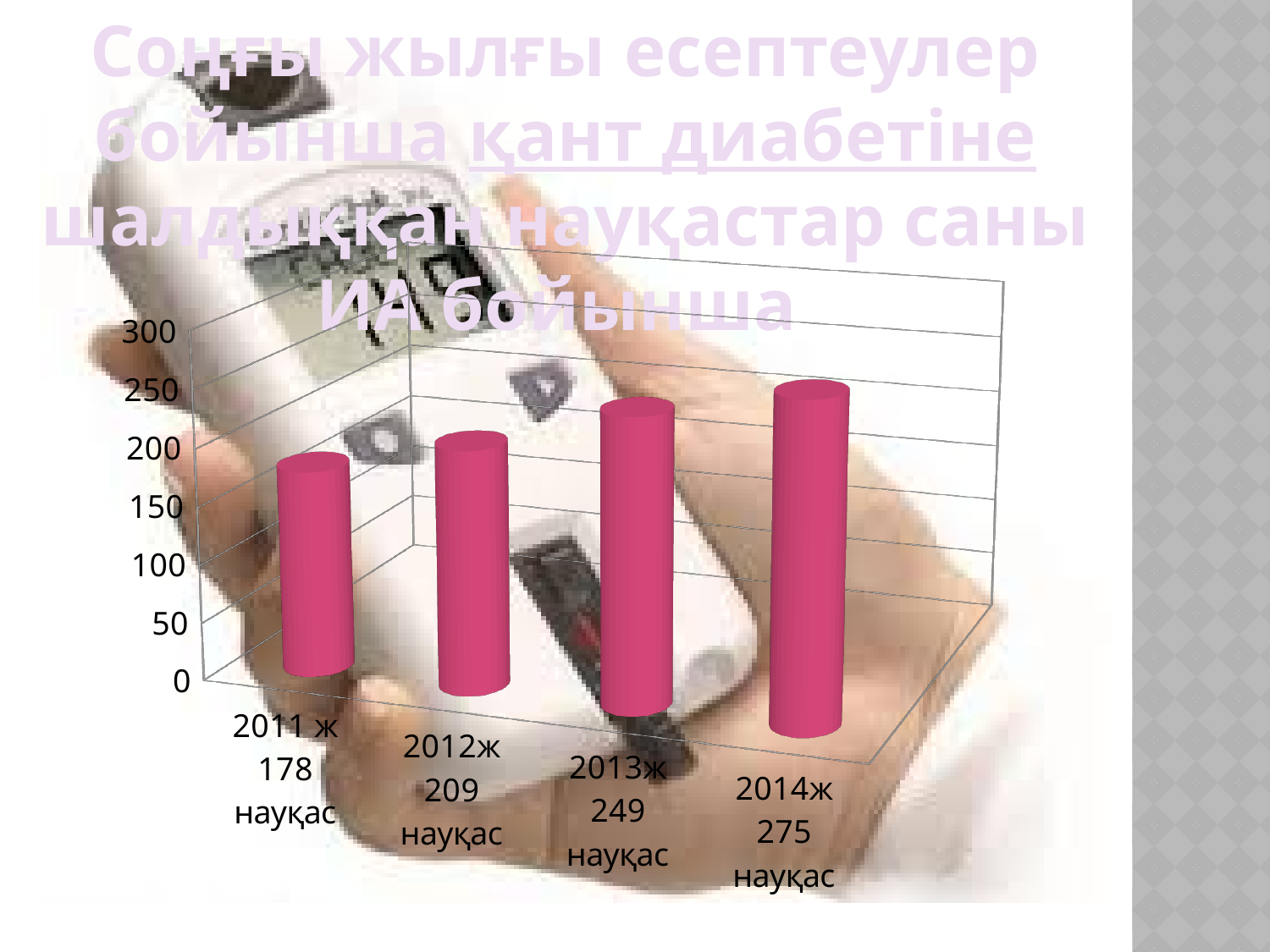
Do the values rise or fall from 2011 ж to 2014ж along the x axis? rise How many patients (науқас) are shown for 2012ж? 209 How many patients (науқас) are shown for 2013ж? 249 What kind of chart is shown on the slide? bar chart Which year has the highest number of patients? 2014ж How many categories (years) are plotted in the chart? 4 Which has more patients, 2012ж or 2013ж? 2013ж What is the difference in the number of patients between 2013ж and 2012ж? 40 Which year has the lowest number of patients? 2011 ж What is the difference in the number of patients between 2014ж and 2011 ж? 97 How many patients (науқас) are shown for 2014ж? 275 How many patients (науқас) are shown for 2011 ж? 178